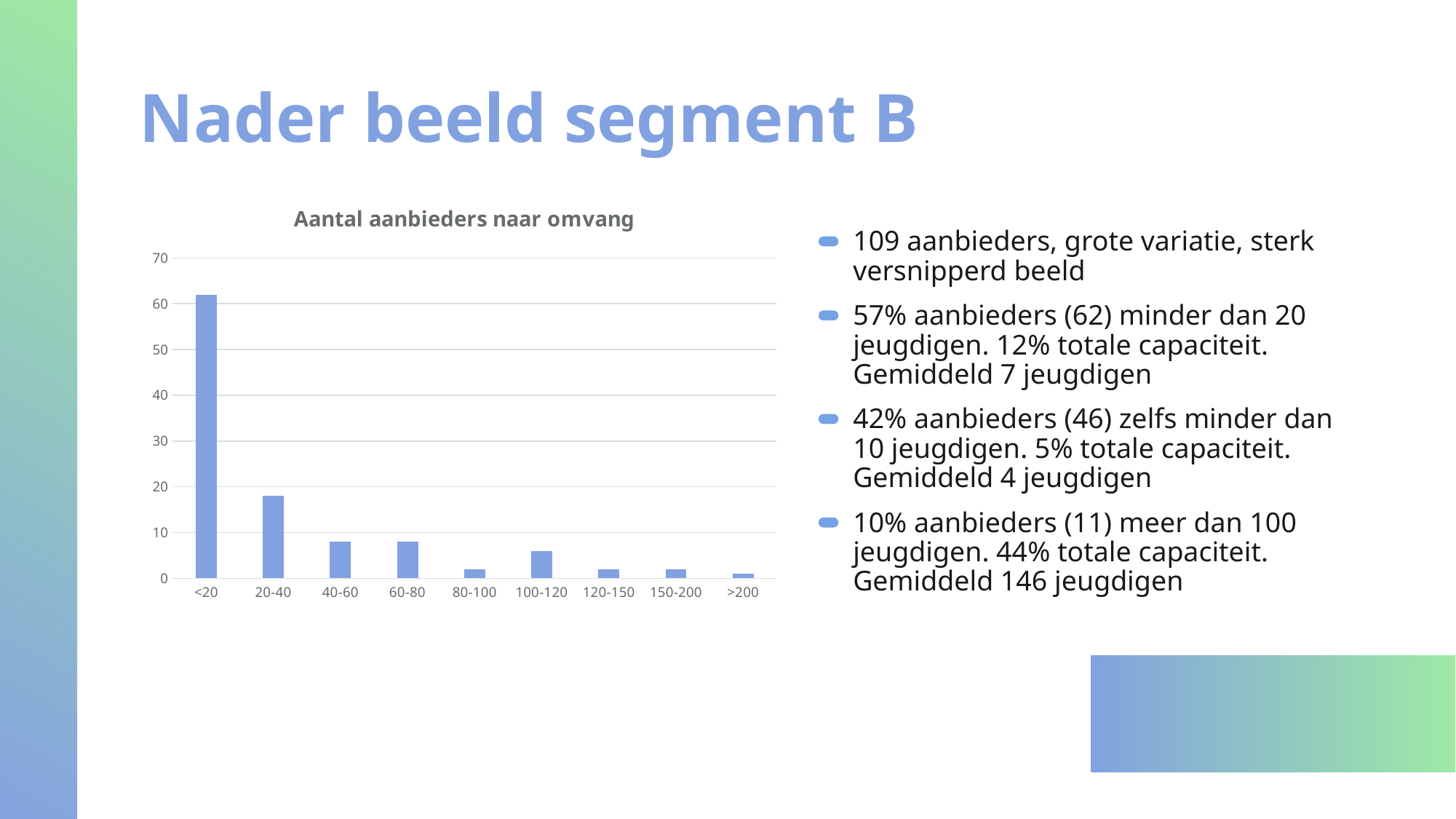
Which is larger, the value for <20 or the value for 20-40? <20 Which category has the highest number of aanbieders? <20 Is the value for 20-40 greater or less than 10? greater Is the value for 100-120 greater or less than 10? less What kind of chart is shown on the slide? bar chart What is the title of the chart? Aantal aanbieders naar omvang Do the values generally rise or fall moving from <20 to >200 along the x axis? fall Is the value for <20 greater or less than 60? greater How many size categories are shown on the x axis of the chart? 9 Which is larger, the value for 100-120 or the value for 80-100? 100-120